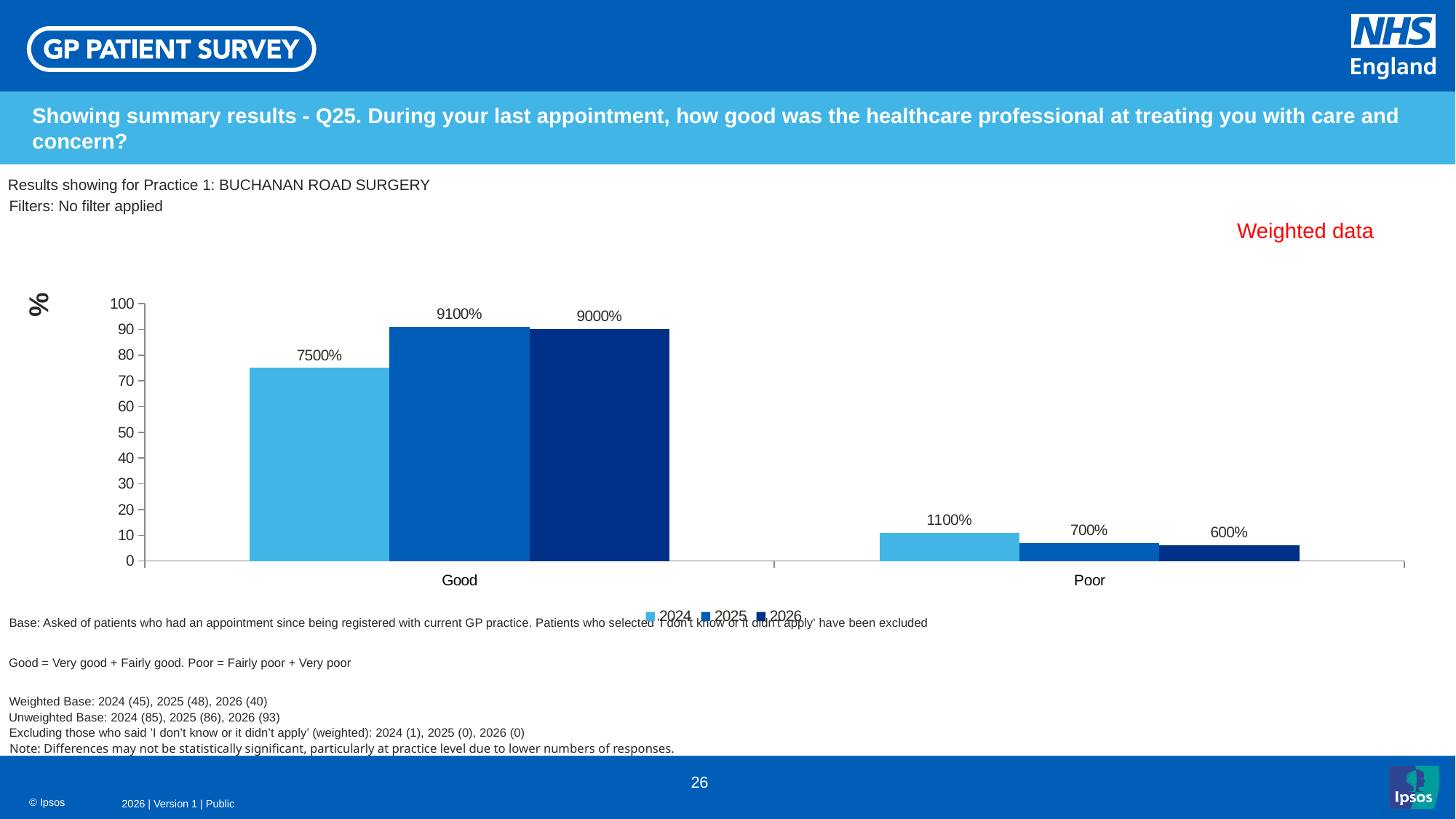
Is the 2026 bar for Good above or below the 80 mark on the axis? above Which year has the highest bar in the Good category? 2025 What is the data label shown for 2025 in the Good category? 9100% What kind of chart is shown on the slide? Bar chart Which year has the lowest bar in the Poor category? 2026 How many categories are shown on the x axis? 2 What is the data label shown for 2024 in the Poor category? 1100% What is the data label shown for 2026 in the Poor category? 600% How many series does the legend list? 3 Which is larger in the Poor category, the 2024 bar or the 2025 bar? 2024 Which practice are the results shown for? Practice 1: BUCHANAN ROAD SURGERY What is the data label shown for 2024 in the Good category? 7500%